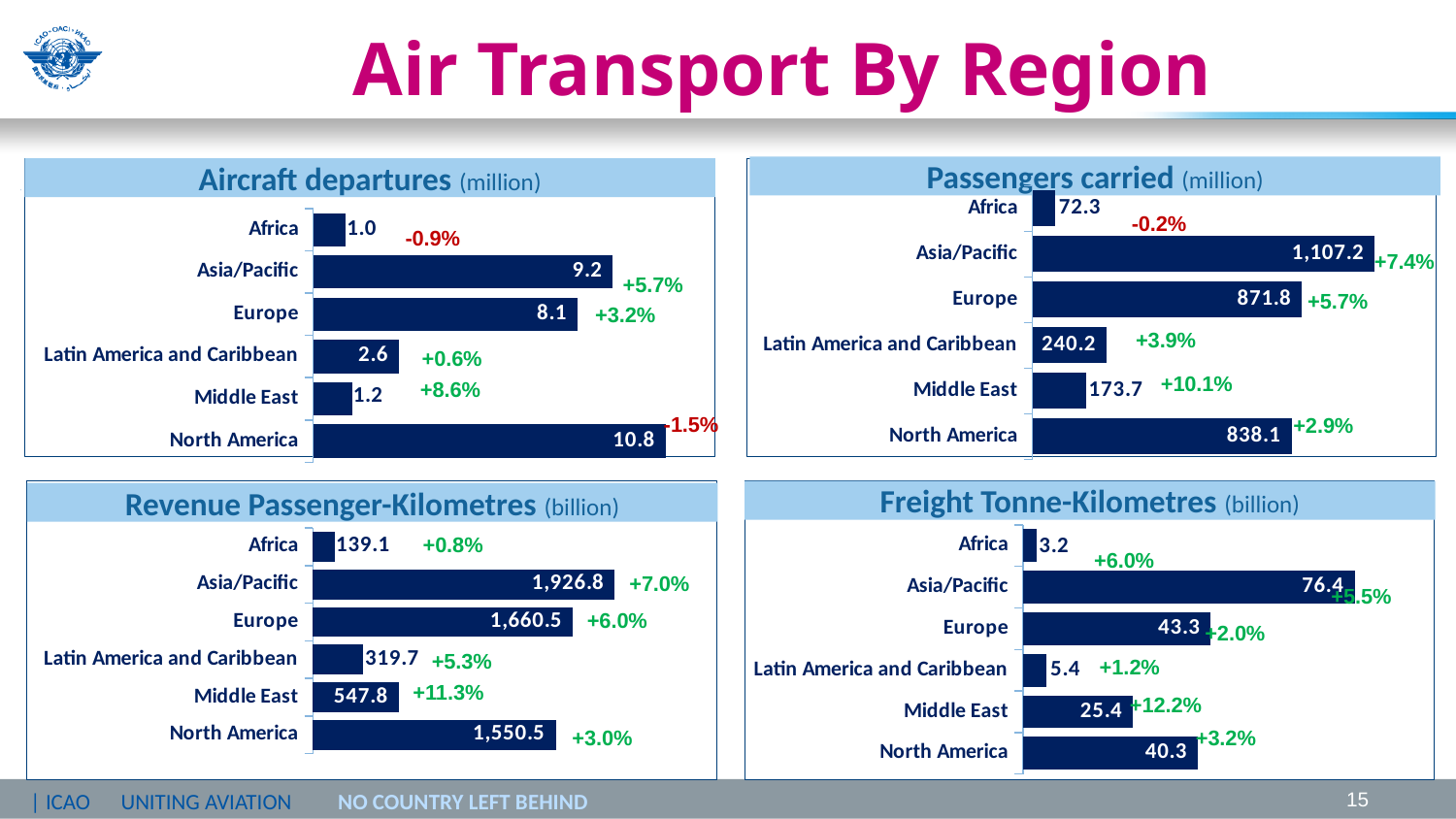
What type of chart is the Revenue Passenger-Kilometres chart? Bar chart In the Passengers carried chart, what percentage change is shown for the Middle East? +10.1% In the Freight Tonne-Kilometres chart, what is the difference between Europe and North America? 3.0 In the Revenue Passenger-Kilometres chart, which is larger, Middle East or Latin America and Caribbean? Middle East In the Aircraft departures chart, which region has the highest value? North America In the Passengers carried chart, what is the value for Asia/Pacific? 1,107.2 How many regions are shown in the Freight Tonne-Kilometres chart? 6 In the Revenue Passenger-Kilometres chart, what is the value for Europe? 1,660.5 In the Aircraft departures chart, what is the difference between Asia/Pacific and Europe? 1.1 In the Freight Tonne-Kilometres chart, what is the value for Europe? 43.3 In the Aircraft departures chart, what is the value for North America? 10.8 In the Passengers carried chart, which region has the lowest value? Africa